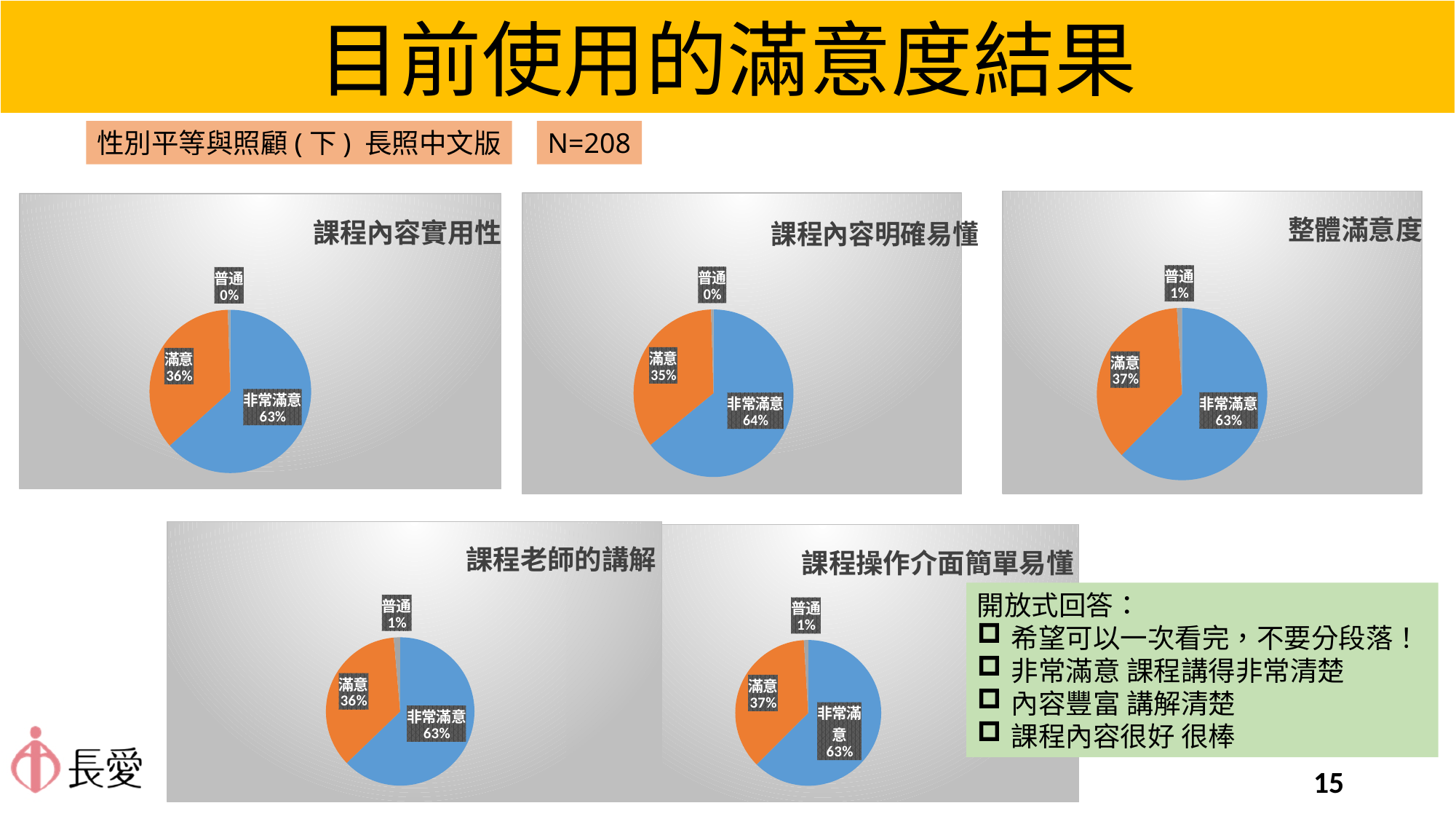
In the chart titled 整體滿意度, what share of respondents answered 滿意? 37% In the chart titled 課程操作介面簡單易懂, which category has the smallest slice? 普通 In the chart titled 課程內容實用性, what share of respondents answered 非常滿意? 63% In the chart titled 整體滿意度, what share of respondents answered 普通? 1% In the chart titled 課程內容明確易懂, what share of respondents answered 滿意? 35% In the chart titled 課程老師的講解, which is larger, the 滿意 slice or the 非常滿意 slice? 非常滿意 In the chart titled 課程老師的講解, which category has the largest slice? 非常滿意 In the chart titled 課程內容實用性, what share of respondents answered 滿意? 36% What type of chart is used for 整體滿意度? Pie chart In the chart titled 課程內容明確易懂, what share of respondents answered 非常滿意? 64% How many categories are shown in the chart titled 課程操作介面簡單易懂? 3 In the chart titled 課程內容明確易懂, what is the difference between the 非常滿意 share and the 滿意 share? 29%